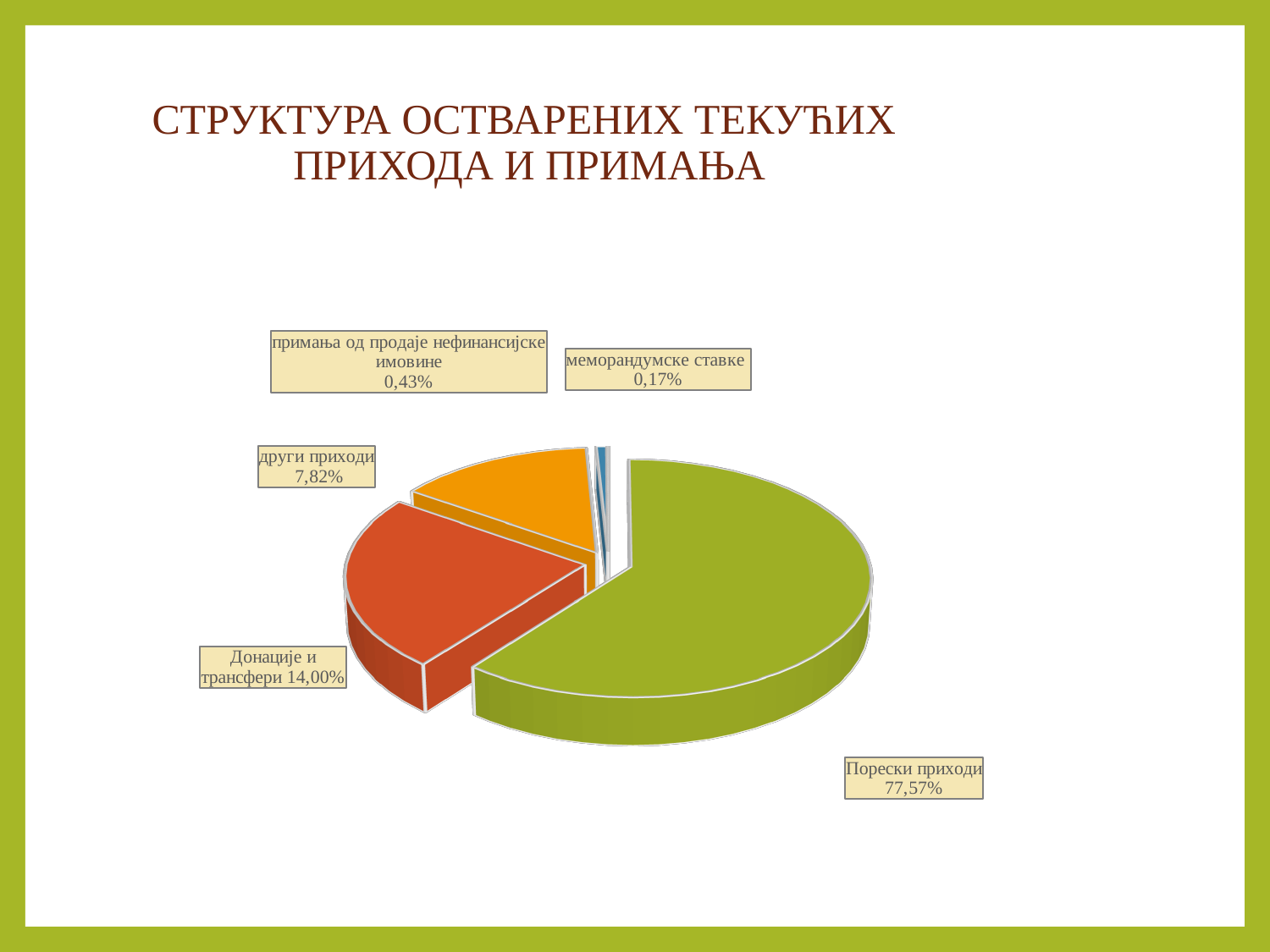
Which category has the smallest slice of the pie? меморандумске ставке What is the title of the slide containing the pie chart? СТРУКТУРА ОСТВАРЕНИХ ТЕКУЋИХ ПРИХОДА И ПРИМАЊА What is the difference between the values for Порески приходи and Донације и трансфери? 63,57% What is the value shown for Донације и трансфери? 14,00% What kind of chart is shown on the slide? pie chart How many slices does the pie chart have? 5 Which is larger, Донације и трансфери or други приходи? Донације и трансфери What is the value shown for примања од продаје нефинансијске имовине? 0,43% What is the value shown for други приходи? 7,82% Which category has the largest slice of the pie? Порески приходи What is the value shown for Порески приходи? 77,57% What is the value shown for меморандумске ставке? 0,17%